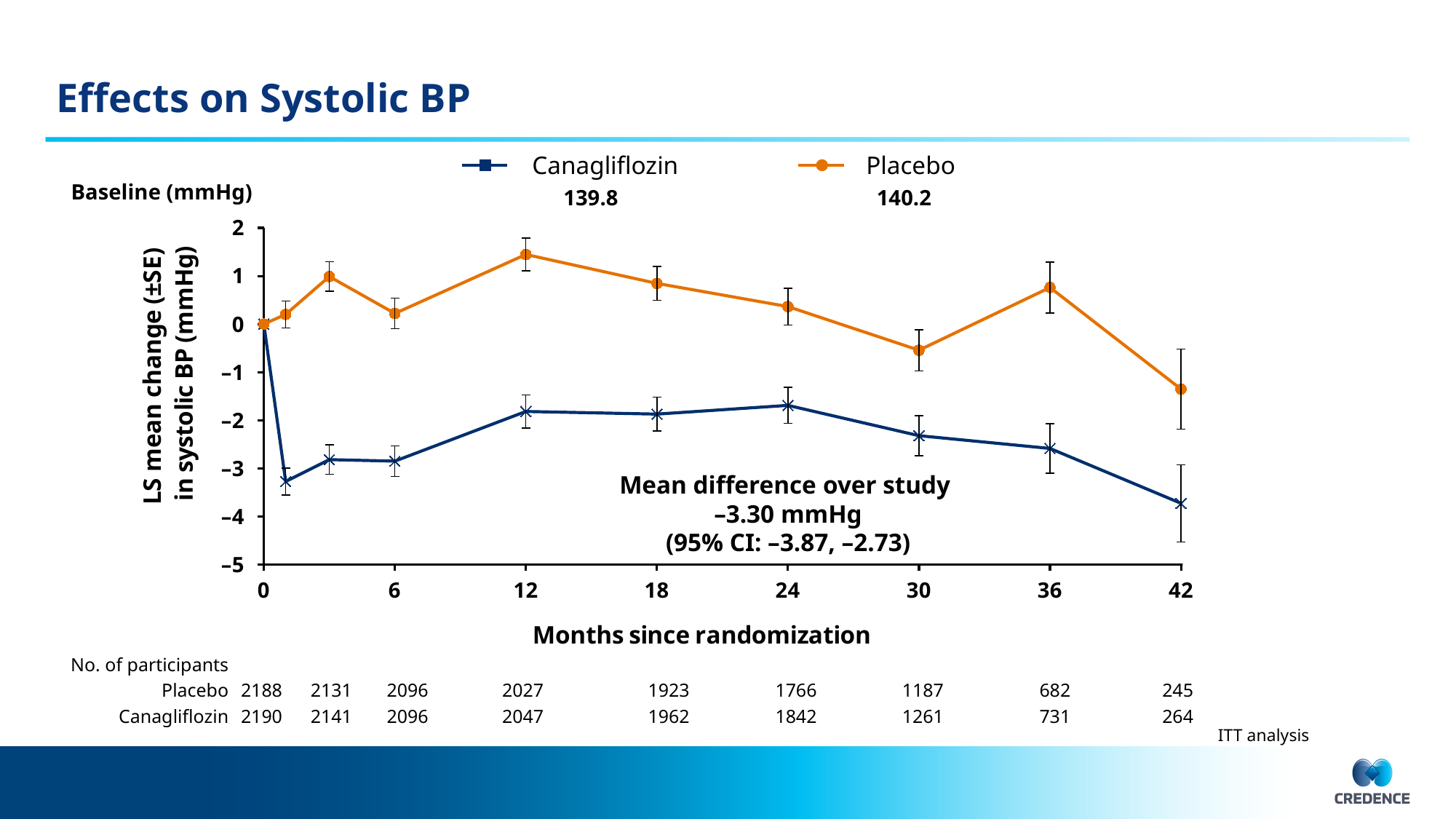
How many Placebo participants are listed at month 42? 245 Does the Placebo line rise or fall between month 36 and month 42? fall Is the LS mean change for Canagliflozin at month 42 greater or less than –3? less What kind of chart is shown on the slide? line chart How many series does the legend list? 2 What is the baseline systolic BP (mmHg) shown for Canagliflozin? 139.8 Which two series are listed in the legend? Canagliflozin and Placebo What is the baseline systolic BP (mmHg) shown for Placebo? 140.2 Is the LS mean change for Placebo at month 12 greater or less than 1? greater At month 12, which series has the higher LS mean change in systolic BP? Placebo What is the mean difference over study stated on the chart? –3.30 mmHg Is the LS mean change for Placebo at month 42 greater or less than 0? less